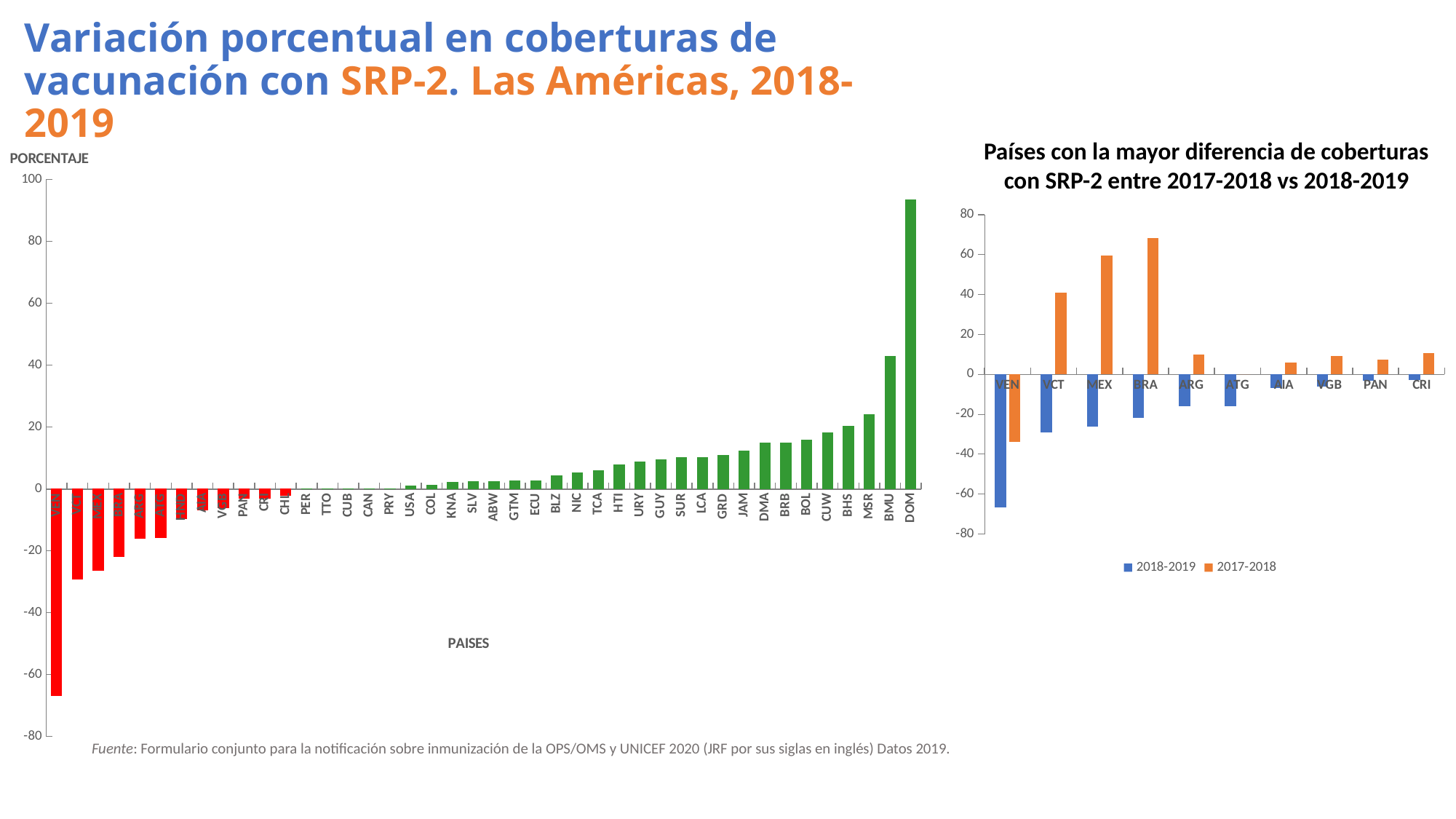
In the left chart, which country has the lowest value? VEN In the left chart, is the value for DOM greater or less than 80? greater In the chart titled 'Países con la mayor diferencia de coberturas con SRP-2 entre 2017-2018 vs 2018-2019', which country has the lowest 2018-2019 value? VEN In the chart titled 'Países con la mayor diferencia de coberturas con SRP-2 entre 2017-2018 vs 2018-2019', is the 2017-2018 value for BRA greater or less than 60? greater In the left chart, is the value for VEN greater or less than -60? less In the chart titled 'Países con la mayor diferencia de coberturas con SRP-2 entre 2017-2018 vs 2018-2019', how many countries are shown on the x axis? 10 In the left chart, which country has the highest value? DOM In the left chart, do the values rise or fall moving from left to right along the x axis? rise In the chart titled 'Países con la mayor diferencia de coberturas con SRP-2 entre 2017-2018 vs 2018-2019', which series is shown in orange? 2017-2018 In the chart titled 'Países con la mayor diferencia de coberturas con SRP-2 entre 2017-2018 vs 2018-2019', which country has the highest 2017-2018 value? BRA What kind of chart is the left chart on the slide? bar chart In the chart titled 'Países con la mayor diferencia de coberturas con SRP-2 entre 2017-2018 vs 2018-2019', how many series does the legend list? 2